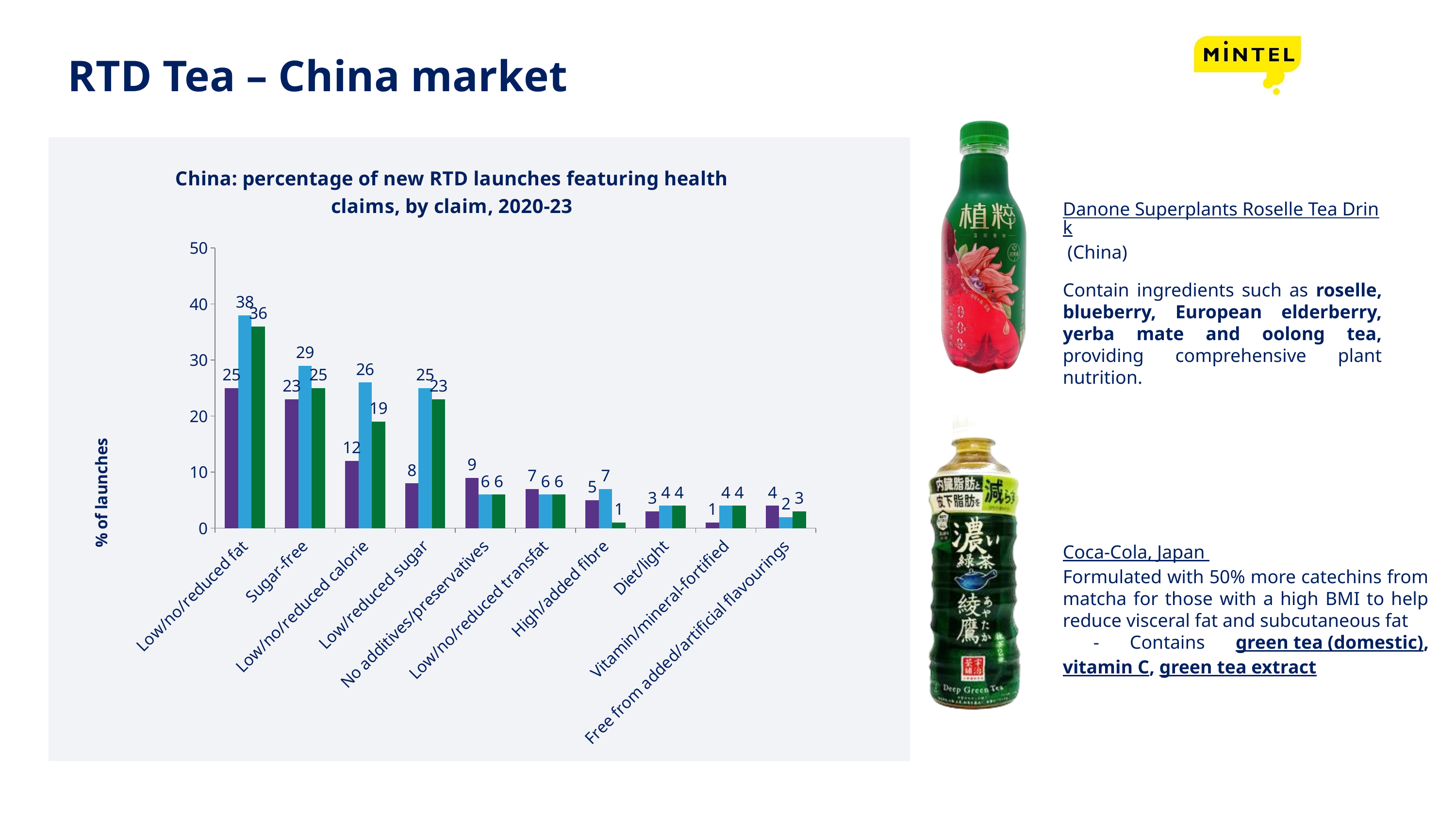
Is the value of the blue bar for Sugar-free greater or less than 20? greater What is the value of the green bar for High/added fibre? 1 How many bars are plotted for each claim category in the chart? 3 What kind of chart is shown on the slide? Bar chart What is the difference between the blue bar and the purple bar for Low/reduced sugar? 17 Which claim category has the lowest purple bar? Vitamin/mineral-fortified What is the value of the blue bar for Low/no/reduced fat? 38 What is the label on the y axis of the chart? % of launches For Sugar-free, which is larger: the purple bar or the green bar? The green bar How many claim categories are shown on the x axis of the chart? 10 What is the value of the purple bar for Low/no/reduced calorie? 12 Which claim category has the highest blue bar? Low/no/reduced fat